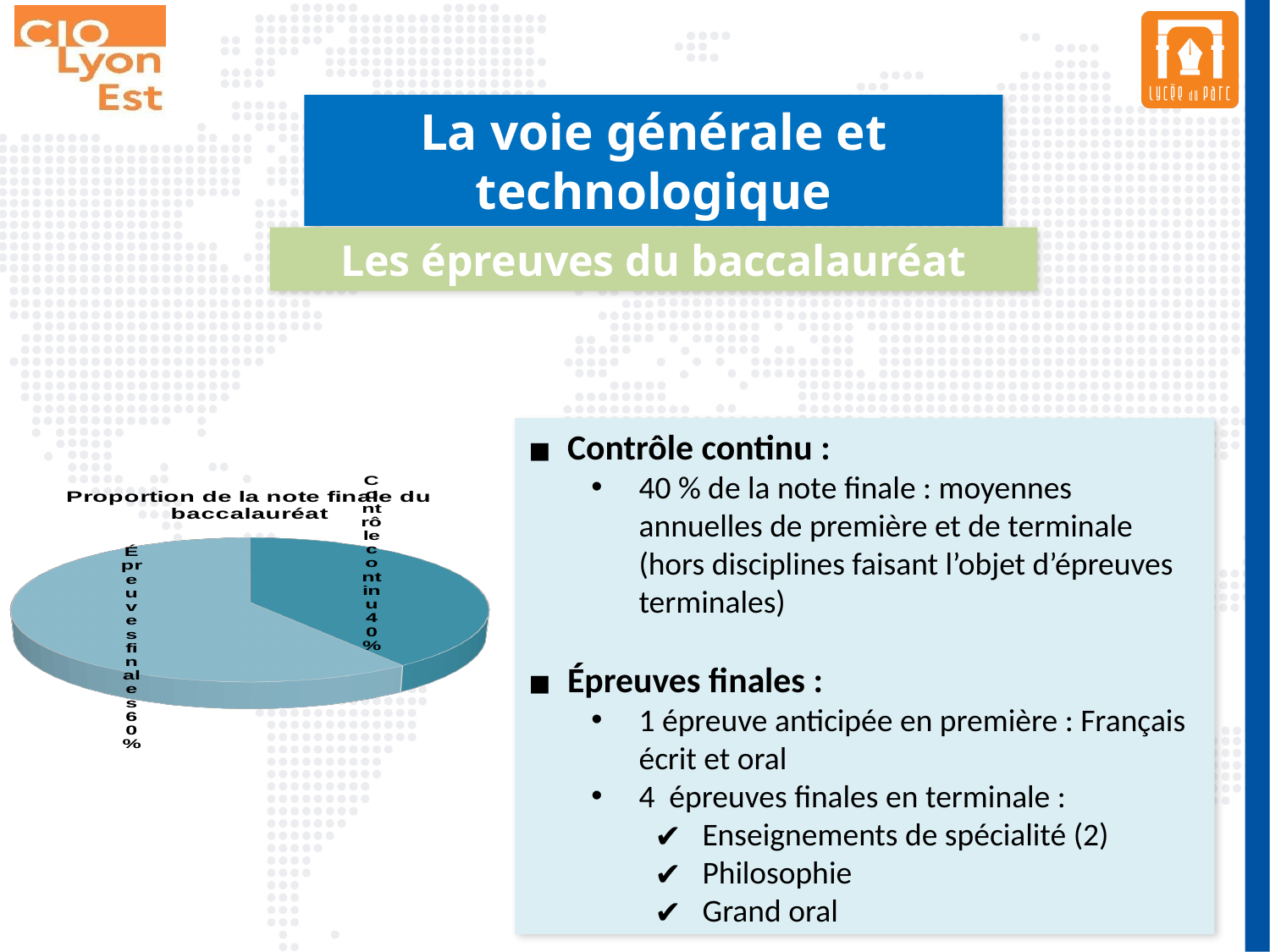
What is the total of the two slices shown in the pie chart? 100% Which is larger, the share for "Contrôle continu" or the share for "Épreuves finales"? Épreuves finales What share of the pie does "Contrôle continu" represent? 40% What is the title of the chart? Proportion de la note finale du baccalauréat What kind of chart is shown on the slide? Pie chart Which slice of the pie chart is the smallest? Contrôle continu What share of the pie does "Épreuves finales" represent? 60% Is the share for "Contrôle continu" greater or less than 50%? less Which slice of the pie chart is the largest? Épreuves finales Is the share for "Épreuves finales" greater or less than 50%? greater What is the difference in percentage points between the "Épreuves finales" slice and the "Contrôle continu" slice? 20 percentage points How many slices does the pie chart have? 2